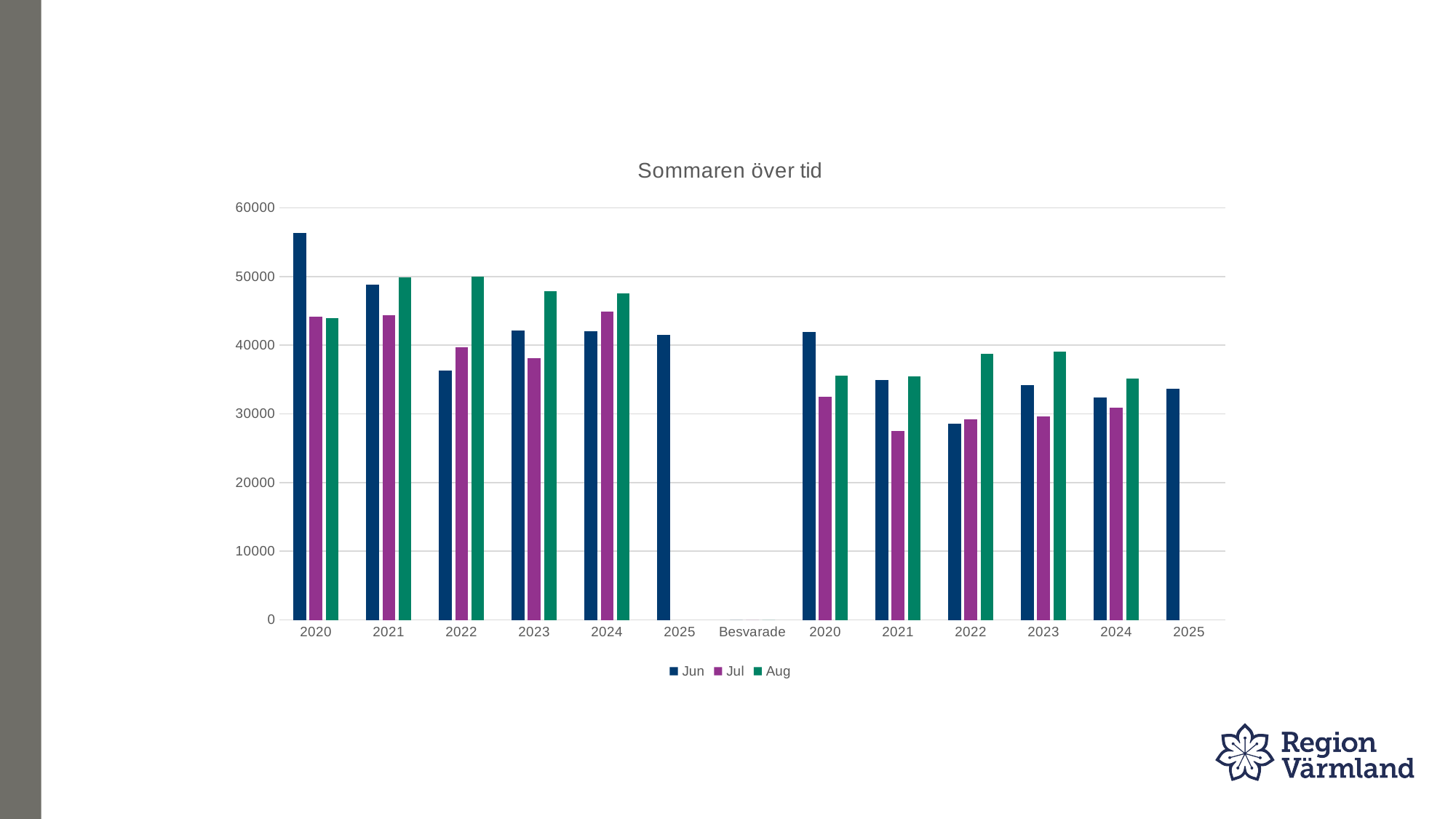
How many series does the legend list? 3 In the left-hand group of years, is the Aug value for 2022 greater or less than 40000? greater In the right-hand group of years (after Besvarade), which series has the lowest value for 2021? Jul What kind of chart is shown on the slide? bar chart In the right-hand group of years (after Besvarade), is the Jul value for 2021 greater or less than 30000? less In the left-hand group of years, is the Jun value for 2020 greater or less than 50000? greater What are the series names listed in the legend? Jun, Jul, Aug Which bar is the tallest in the whole chart? Jun in 2020 (left-hand group) What is the title of the chart? Sommaren över tid In the left-hand group of years, which is larger for 2022: Jun or Aug? Aug In the right-hand group of years (after Besvarade), which is larger for 2023: Jun or Aug? Aug